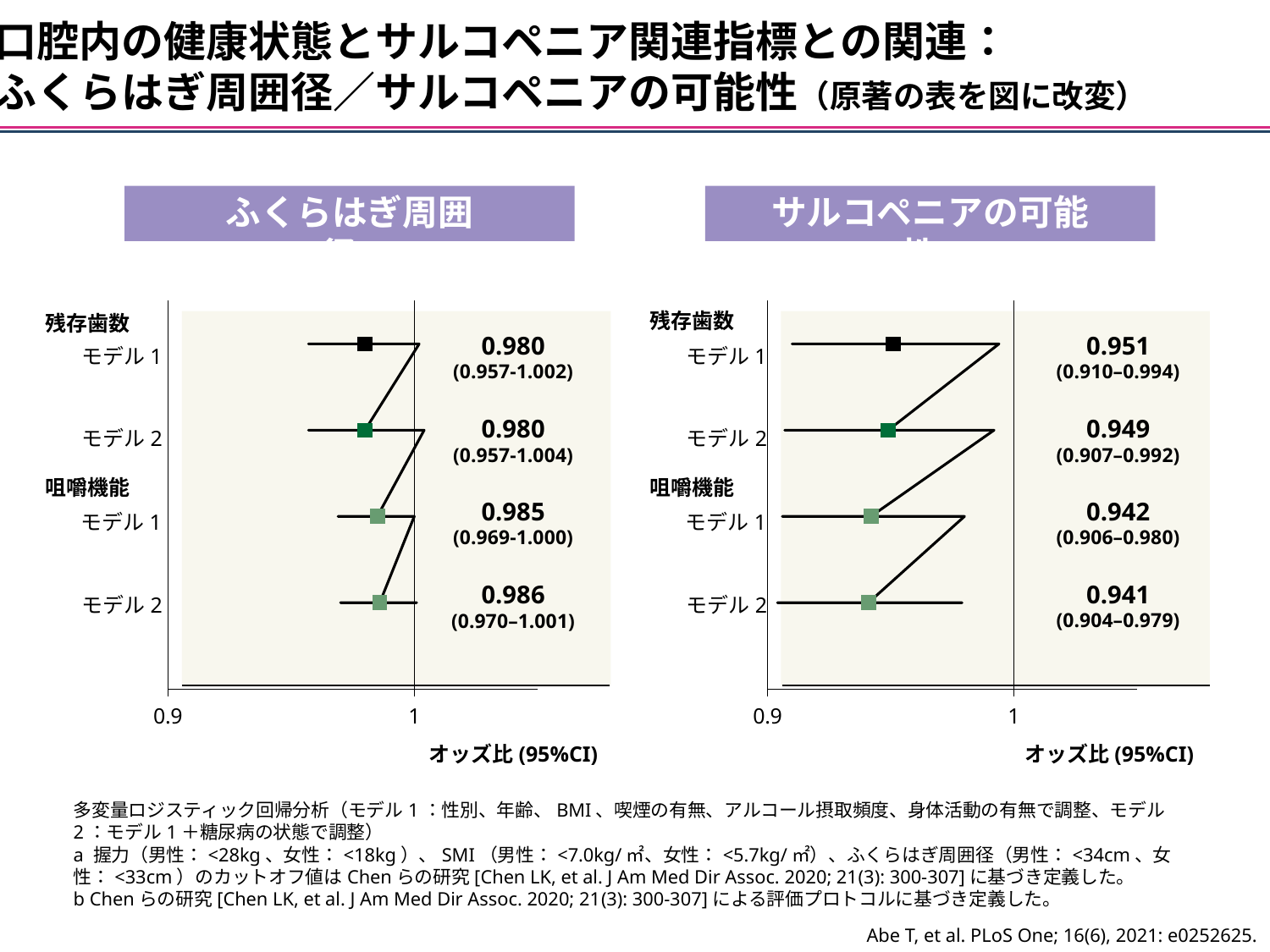
In the サルコペニアの可能性 chart (right), what is the difference between the odds ratios for 残存歯数 モデル 1 and 咀嚼機能 モデル 2? 0.010 In the ふくらはぎ周囲径 chart (left), which is larger: the odds ratio for 咀嚼機能 モデル 1 or for 残存歯数 モデル 2? 咀嚼機能 モデル 1 In the サルコペニアの可能性 chart (right), is the odds ratio for 咀嚼機能 モデル 2 greater or less than 1? less In the ふくらはぎ周囲径 chart (left), which item has the highest odds ratio? 咀嚼機能 モデル 2 In the ふくらはぎ周囲径 chart (left), what is the odds ratio for 残存歯数 モデル 1? 0.980 What is the x-axis label of the サルコペニアの可能性 chart (right)? オッズ比 (95%CI) In the サルコペニアの可能性 chart (right), which item has the highest odds ratio? 残存歯数 モデル 1 In the ふくらはぎ周囲径 chart (left), what is the 95% CI shown for 咀嚼機能 モデル 2? (0.970–1.001) How many odds-ratio points are plotted in the ふくらはぎ周囲径 chart (left)? 4 In the サルコペニアの可能性 chart (right), what is the 95% CI shown for 咀嚼機能 モデル 1? (0.906–0.980) In the サルコペニアの可能性 chart (right), what is the odds ratio for 残存歯数 モデル 2? 0.949 In the サルコペニアの可能性 chart (right), which item has the lowest odds ratio? 咀嚼機能 モデル 2